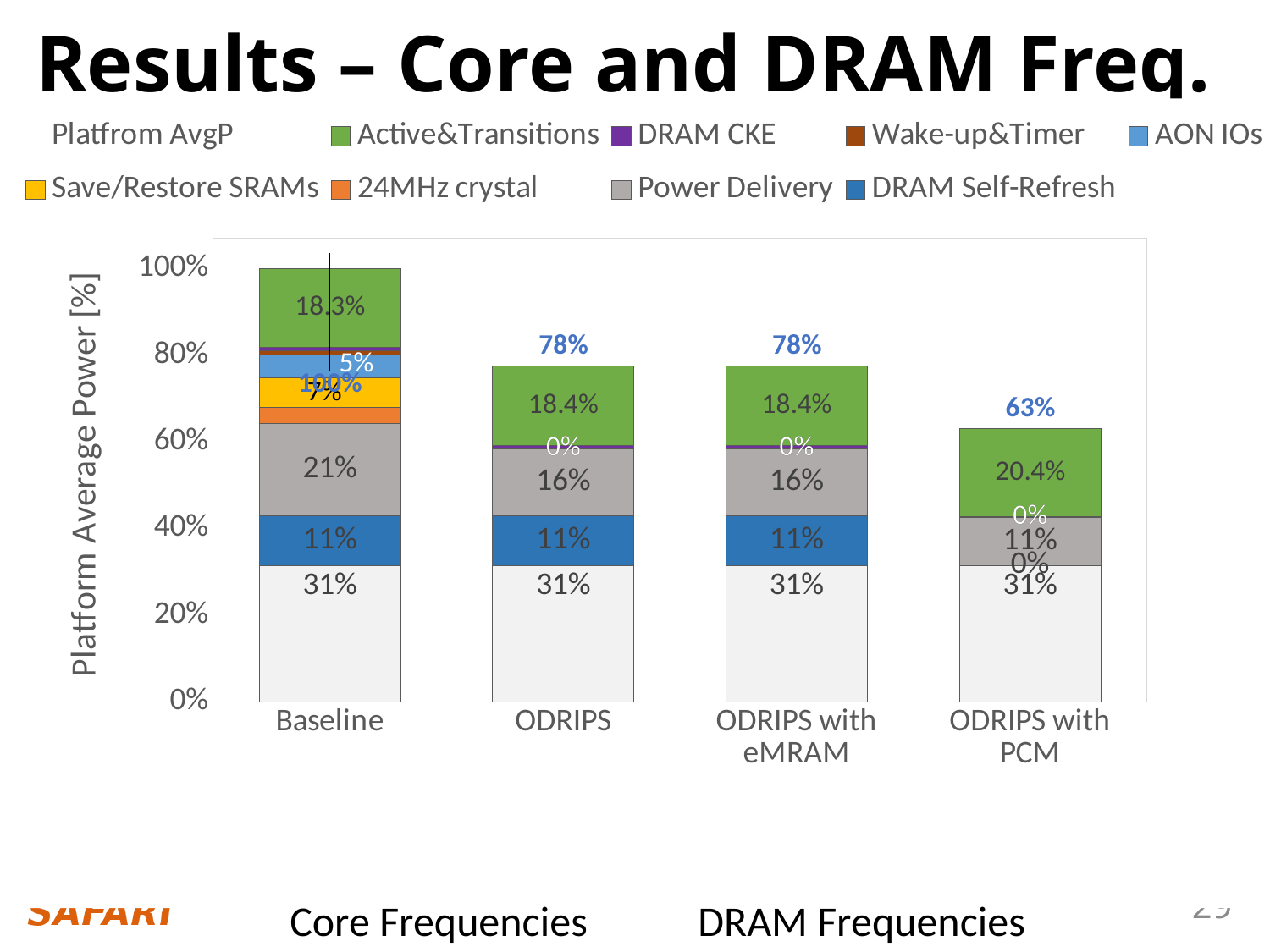
How many series does the legend list? 9 What is the Power Delivery value for ODRIPS? 16% What is the Active&Transitions value for Baseline? 18.3% Which has the larger Power Delivery value, Baseline or ODRIPS? Baseline What is the Active&Transitions value for ODRIPS with PCM? 20.4% How many categories are shown on the x axis of the chart? 4 What is the title of the y axis? Platform Average Power [%] What is the difference between the total for ODRIPS and the total for ODRIPS with PCM? 15% What kind of chart is shown on the slide? Stacked bar chart Which category has the highest total platform average power? Baseline Which category has the lowest total platform average power? ODRIPS with PCM What is the total platform average power for ODRIPS with PCM? 63%